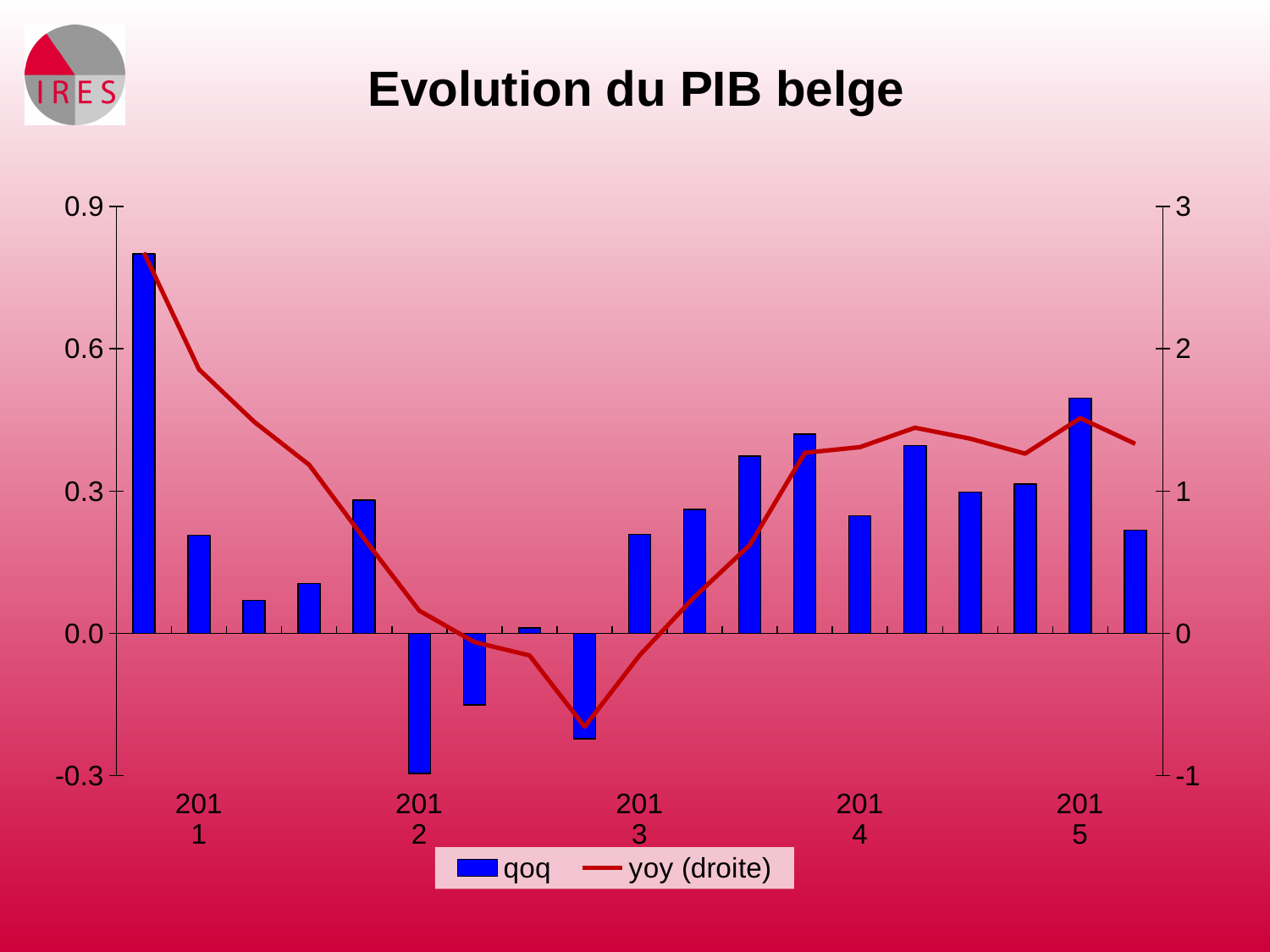
Does the yoy (droite) line rise or fall between the start of 2011 and the start of 2013? fall Which series is plotted against the right-hand axis? yoy (droite) Is the value of the tallest qoq bar in 2015 greater or less than 0.3? greater Is the value of the first (leftmost) qoq bar greater or less than 0.6? greater What kind of chart is shown on the slide? A combination bar and line chart What is the title of the chart? Evolution du PIB belge How many year labels appear on the x axis? 5 What is the highest value shown on the right-hand axis? 3 How many series does the legend list? 2 What are the two series named in the legend? qoq and yoy (droite)